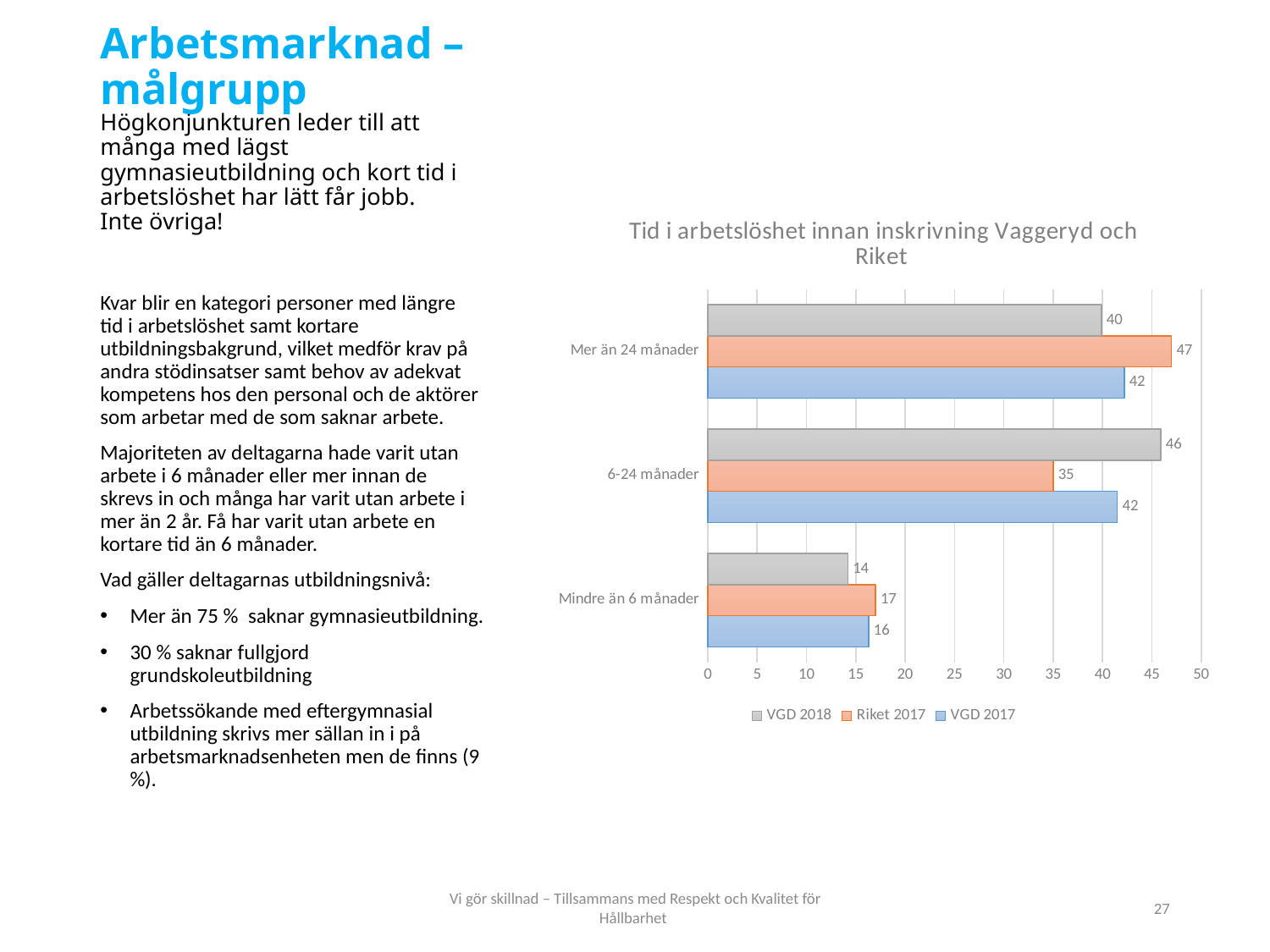
Which category has the lowest value for VGD 2018? Mindre än 6 månader What is the value for VGD 2017 in the 'Mindre än 6 månader' category? 16 Is the value for Riket 2017 in the 'Mindre än 6 månader' category greater or less than 20? less Which category has the highest value for Riket 2017? Mer än 24 månader What is the difference between Riket 2017 and VGD 2018 in the 'Mer än 24 månader' category? 7 What is the value for VGD 2018 in the '6-24 månader' category? 46 What is the title of the chart? Tid i arbetslöshet innan inskrivning Vaggeryd och Riket Which is larger in the '6-24 månader' category: VGD 2018 or Riket 2017? VGD 2018 How many categories are shown on the chart? 3 What kind of chart is shown on the slide? Bar chart What is the value for Riket 2017 in the 'Mer än 24 månader' category? 47 How many series does the legend list? 3